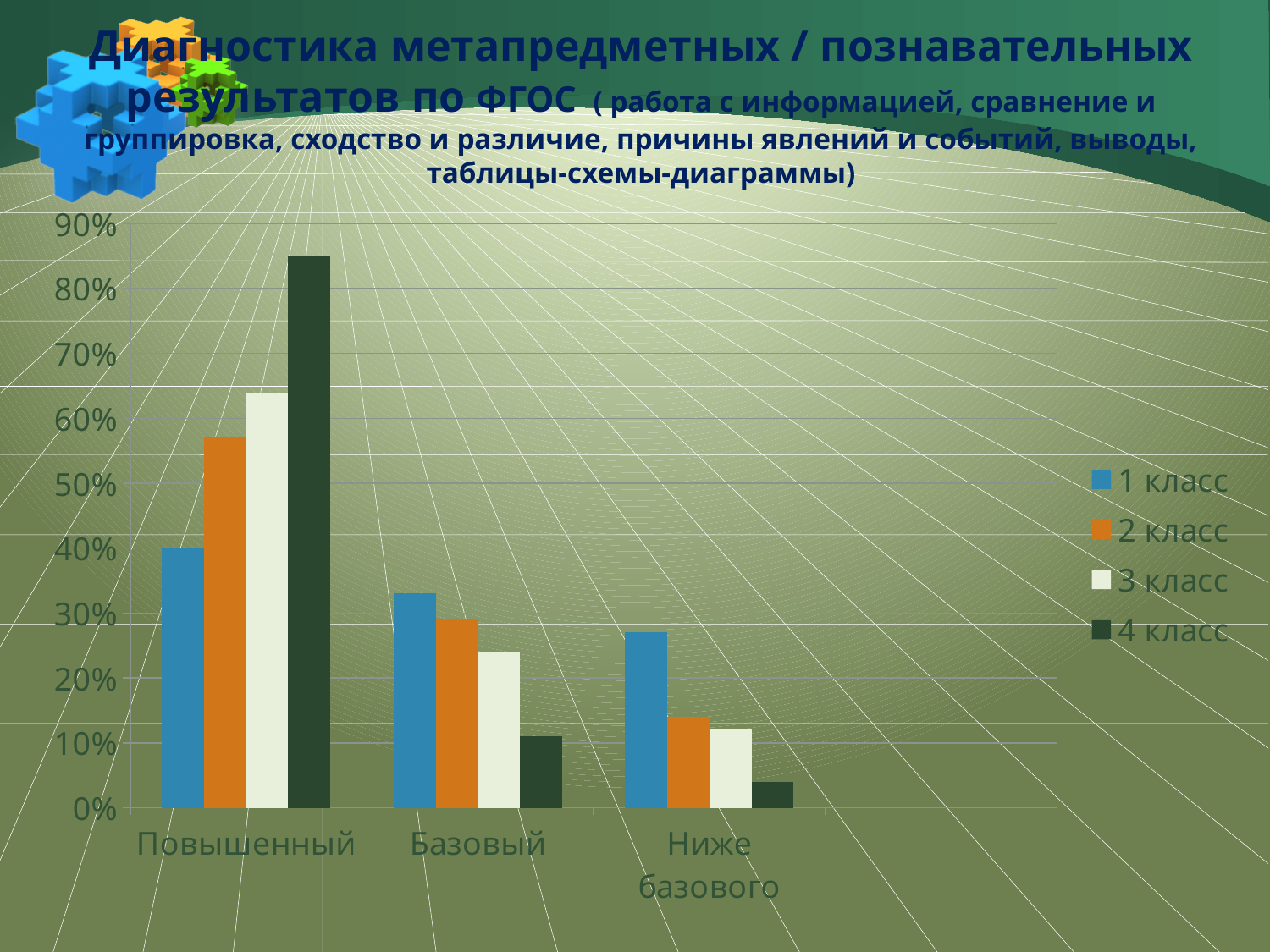
Do the values for 4 класс rise or fall from Повышенный to Ниже базового along the x axis? fall Which legend entry is shown in orange? 2 класс Is the value for 4 класс in the Повышенный category greater or less than 80%? greater Which series has the highest value in the Повышенный category? 4 класс In the Базовый category, which is larger: the value for 1 класс or the value for 4 класс? 1 класс What kind of chart is shown on the slide? bar chart Is the value for 4 класс in the Ниже базового category greater or less than 10%? less Which series has the lowest value in the Ниже базового category? 4 класс How many categories are shown on the x axis? 3 Is the value for 2 класс in the Повышенный category greater or less than 50%? greater Which series has the lowest value in the Повышенный category? 1 класс How many series does the legend list? 4